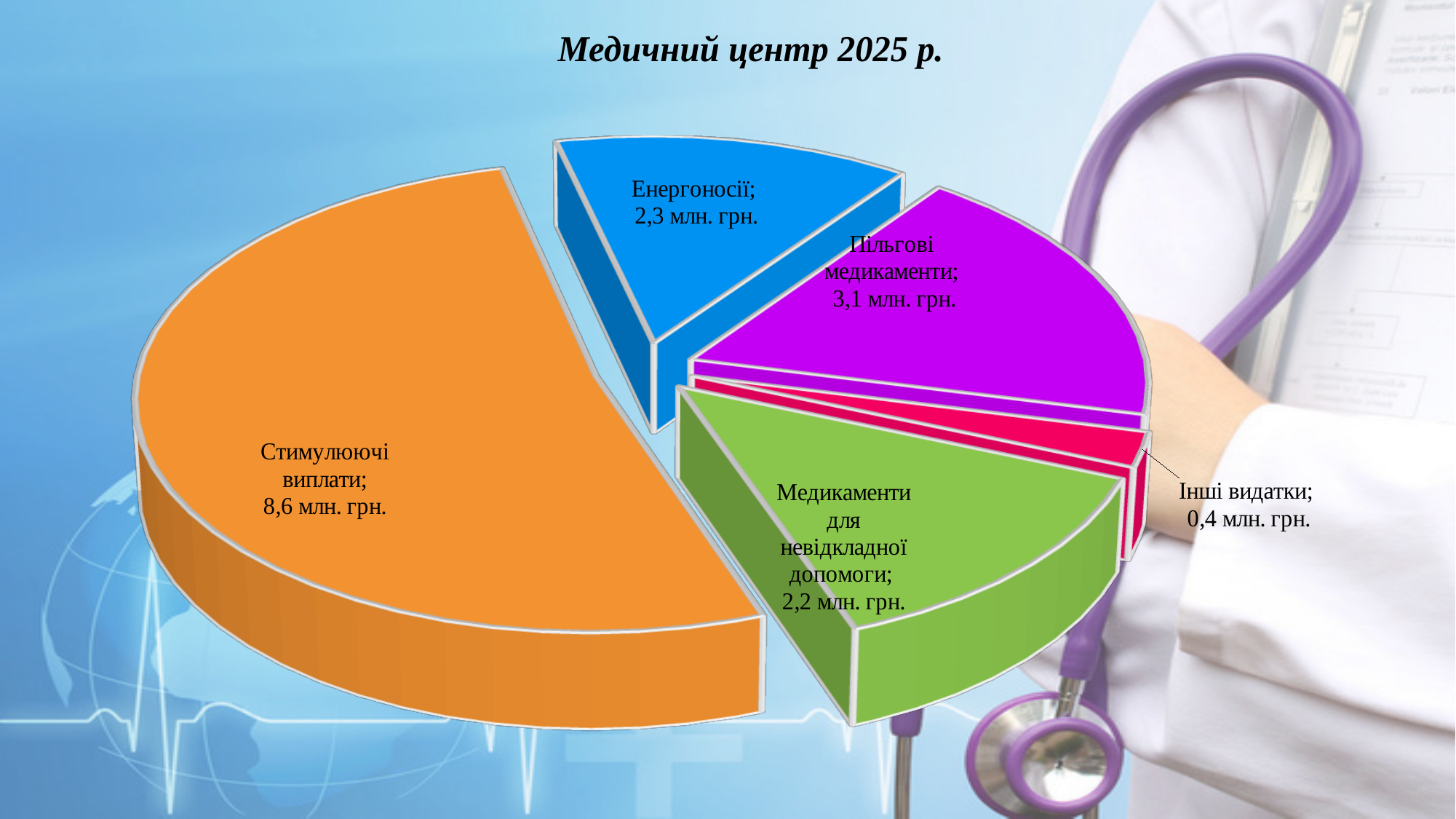
Which category has the largest slice of the pie? Стимулюючі виплати What is the difference between Стимулюючі виплати and Пільгові медикаменти? 5,5 млн. грн. Which is larger, Енергоносії or Медикаменти для невідкладної допомоги? Енергоносії What is the value for Медикаменти для невідкладної допомоги? 2,2 млн. грн. What is the value for Інші видатки? 0,4 млн. грн. Which category has the smallest slice of the pie? Інші видатки What is the value for Стимулюючі виплати? 8,6 млн. грн. What is the title of the chart? Медичний центр 2025 р. What kind of chart is shown on the slide? Pie chart How many categories does the pie chart show? 5 What is the difference between Пільгові медикаменти and Енергоносії? 0,8 млн. грн. What is the value for Пільгові медикаменти? 3,1 млн. грн.